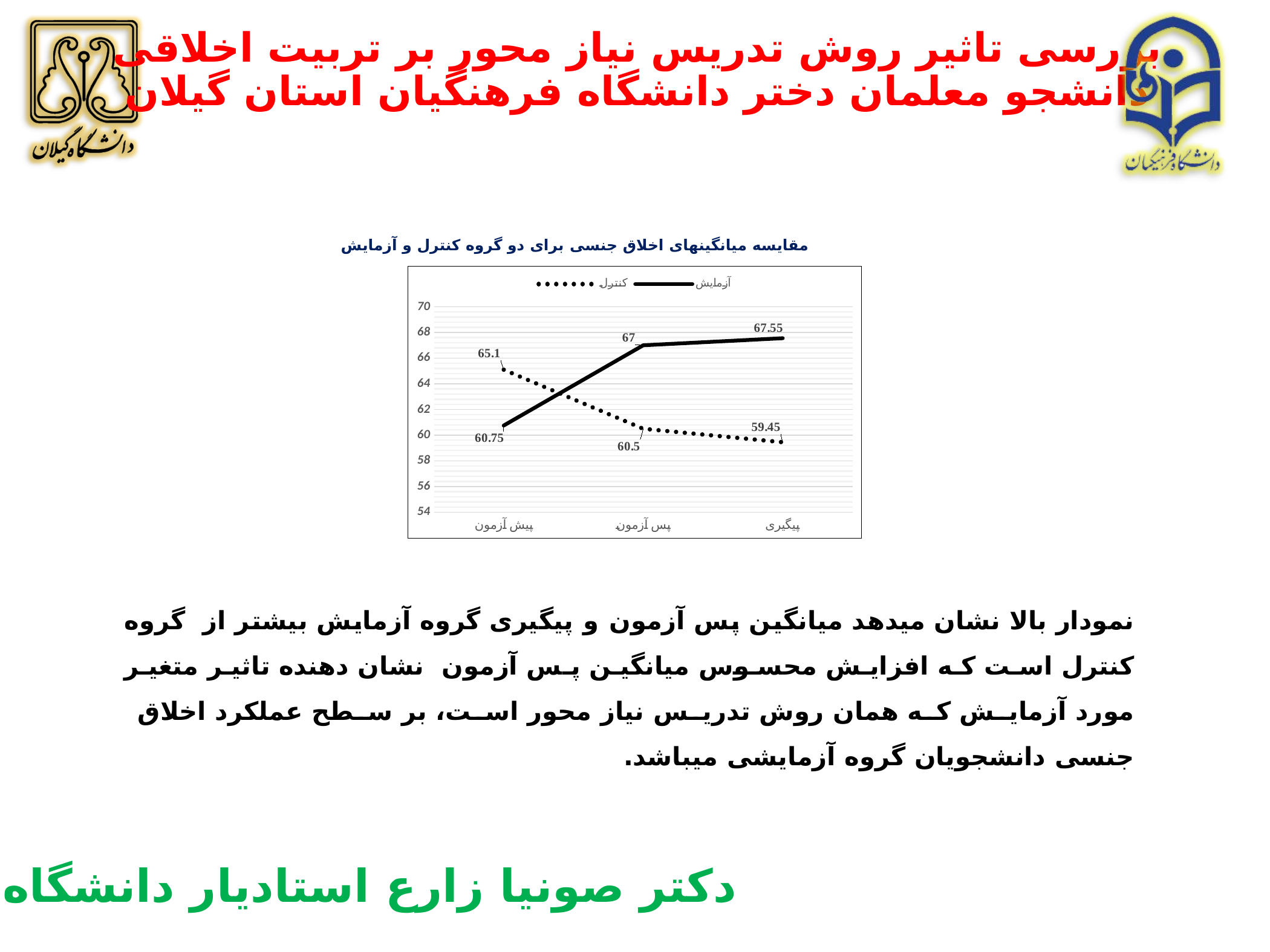
What is the value of the کنترل series at پس آزمون? 60.5 What is the value of the آزمایش series at پیگیری? 67.55 What is the value of the کنترل series at پیش آزمون? 65.1 What type of chart is shown on the slide? line chart Which series has the larger value at پیش آزمون, آزمایش or کنترل? کنترل What is the value of the آزمایش series at پیش آزمون? 60.75 What is the difference between the آزمایش and کنترل values at پس آزمون? 6.5 Does the کنترل series rise or fall from پیش آزمون to پیگیری? fall At which category does the آزمایش series reach its highest value? پیگیری How many series does the chart legend list? 2 At which category does the کنترل series have its lowest value? پیگیری How many categories are shown on the x axis of the chart? 3